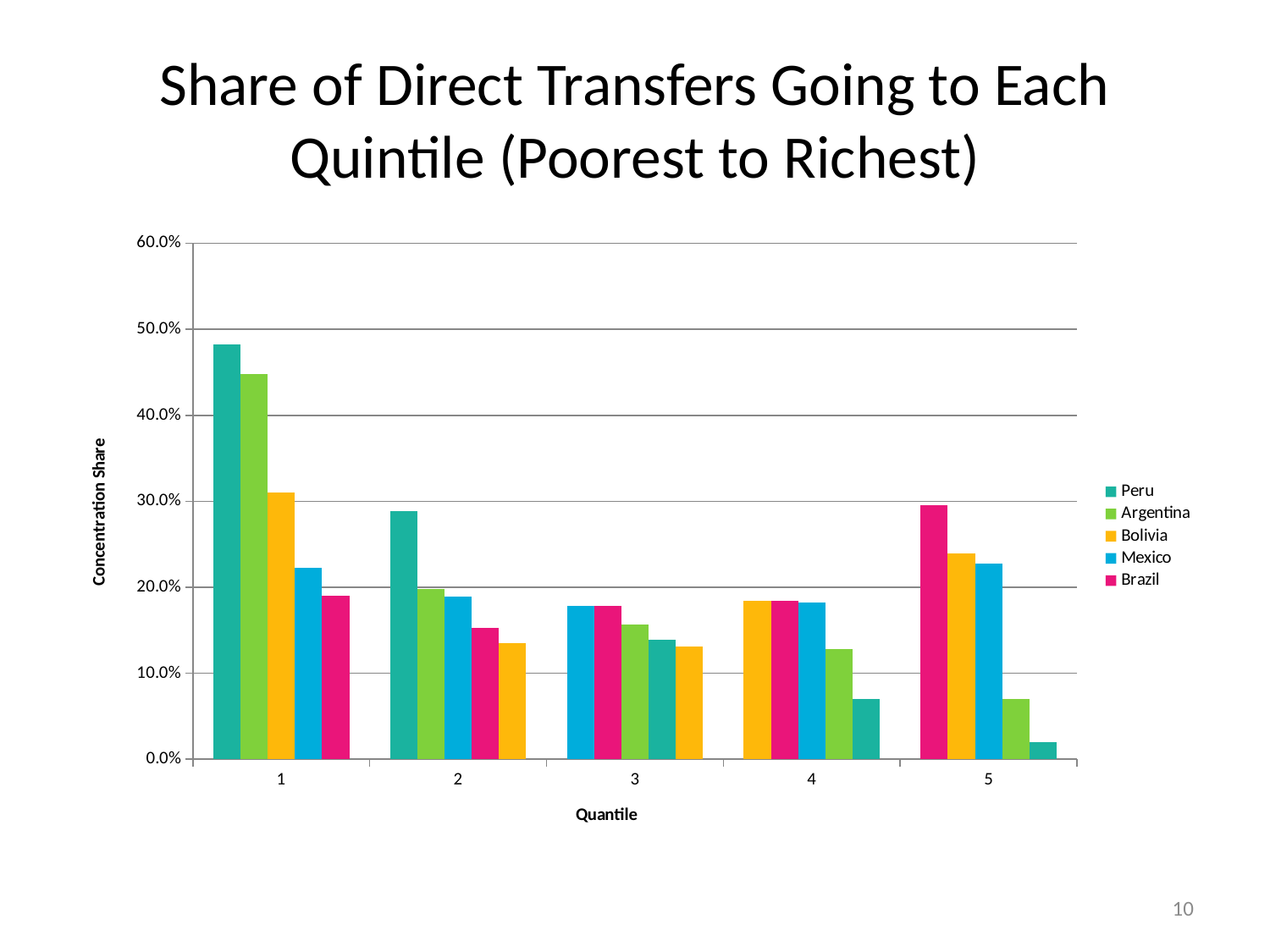
Does Peru's share of direct transfers rise or fall from quintile 1 to quintile 5? fall What is the title of the vertical axis? Concentration Share Is the value for Peru in quintile 5 greater or less than 10.0%? less Which country has the highest share of direct transfers in quintile 5? Brazil In quintile 1, which is larger: the share for Bolivia or the share for Mexico? Bolivia How many countries does the legend list? 5 How many quintiles are shown along the x axis? 5 What kind of chart is shown on the slide? bar chart Is the value for Brazil in quintile 5 greater or less than 20.0%? greater Which country has the highest share of direct transfers in quintile 1? Peru Which country has the lowest share of direct transfers in quintile 5? Peru Is the value for Peru in quintile 1 greater or less than 40.0%? greater